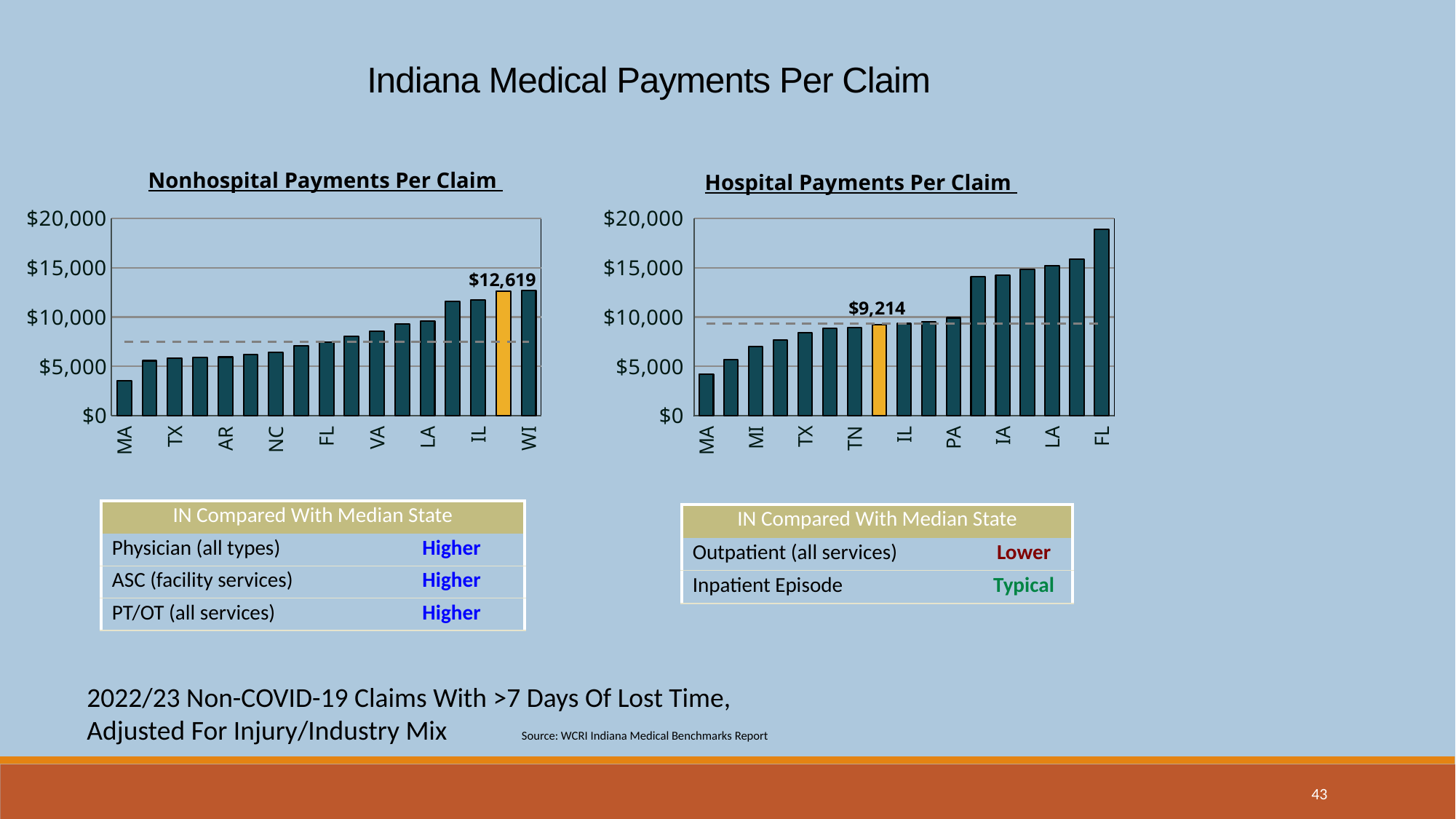
How much larger is the highlighted value in the Nonhospital Payments Per Claim chart ($12,619) than the highlighted value in the Hospital Payments Per Claim chart ($9,214)? $3,405 In the Nonhospital Payments Per Claim chart, which is larger, the value for IL or the value for MA? IL In the Hospital Payments Per Claim chart, what is the value shown for the highlighted (orange) bar? $9,214 In the Nonhospital Payments Per Claim chart, what is the value shown for the highlighted (orange) bar? $12,619 In the Nonhospital Payments Per Claim chart, which labeled state has the lowest value? MA In the Nonhospital Payments Per Claim chart, is the value for MA greater or less than $5,000? less What kind of chart is the Nonhospital Payments Per Claim chart? Bar chart In the Hospital Payments Per Claim chart, is the value for IA greater or less than $10,000? greater In the Nonhospital Payments Per Claim chart, is the value for WI greater or less than $10,000? greater In the Hospital Payments Per Claim chart, which labeled state has the highest value? FL In the Hospital Payments Per Claim chart, do the values rise or fall from left to right along the x axis? Rise